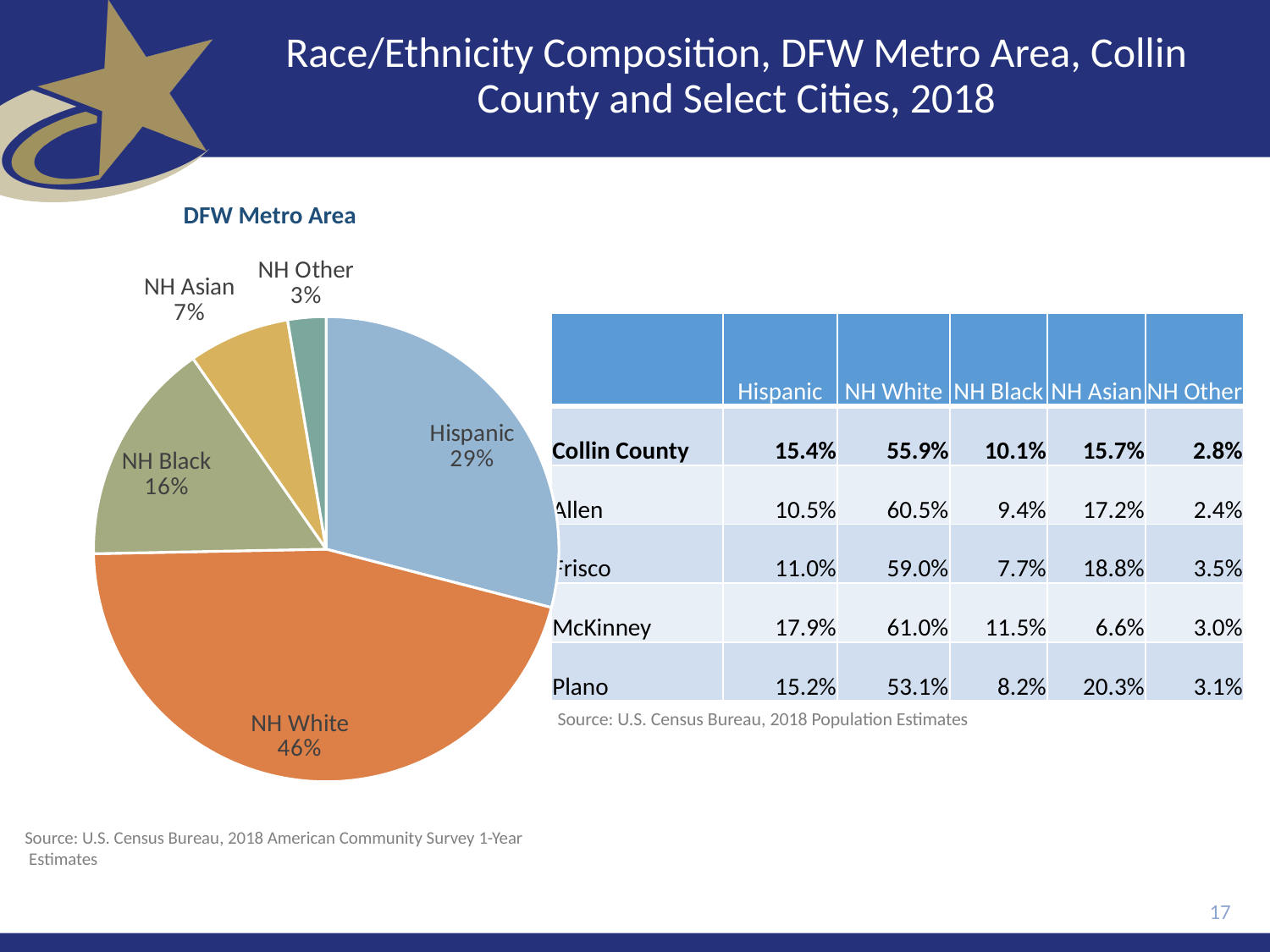
In the DFW Metro Area pie chart, what share is Hispanic? 29% How many slices does the DFW Metro Area pie chart have? 5 In the DFW Metro Area pie chart, what share is NH Other? 3% In the DFW Metro Area pie chart, what share is NH White? 46% In the DFW Metro Area pie chart, how many percentage points larger is NH White than Hispanic? 17 In the DFW Metro Area pie chart, which is larger, NH Black or NH Asian? NH Black In the DFW Metro Area pie chart, what share is NH Black? 16% Which slice is the largest in the DFW Metro Area pie chart? NH White What kind of chart is the DFW Metro Area chart? pie chart Which slice is the smallest in the DFW Metro Area pie chart? NH Other What is the title of the pie chart on the slide? DFW Metro Area In the DFW Metro Area pie chart, what share is NH Asian? 7%